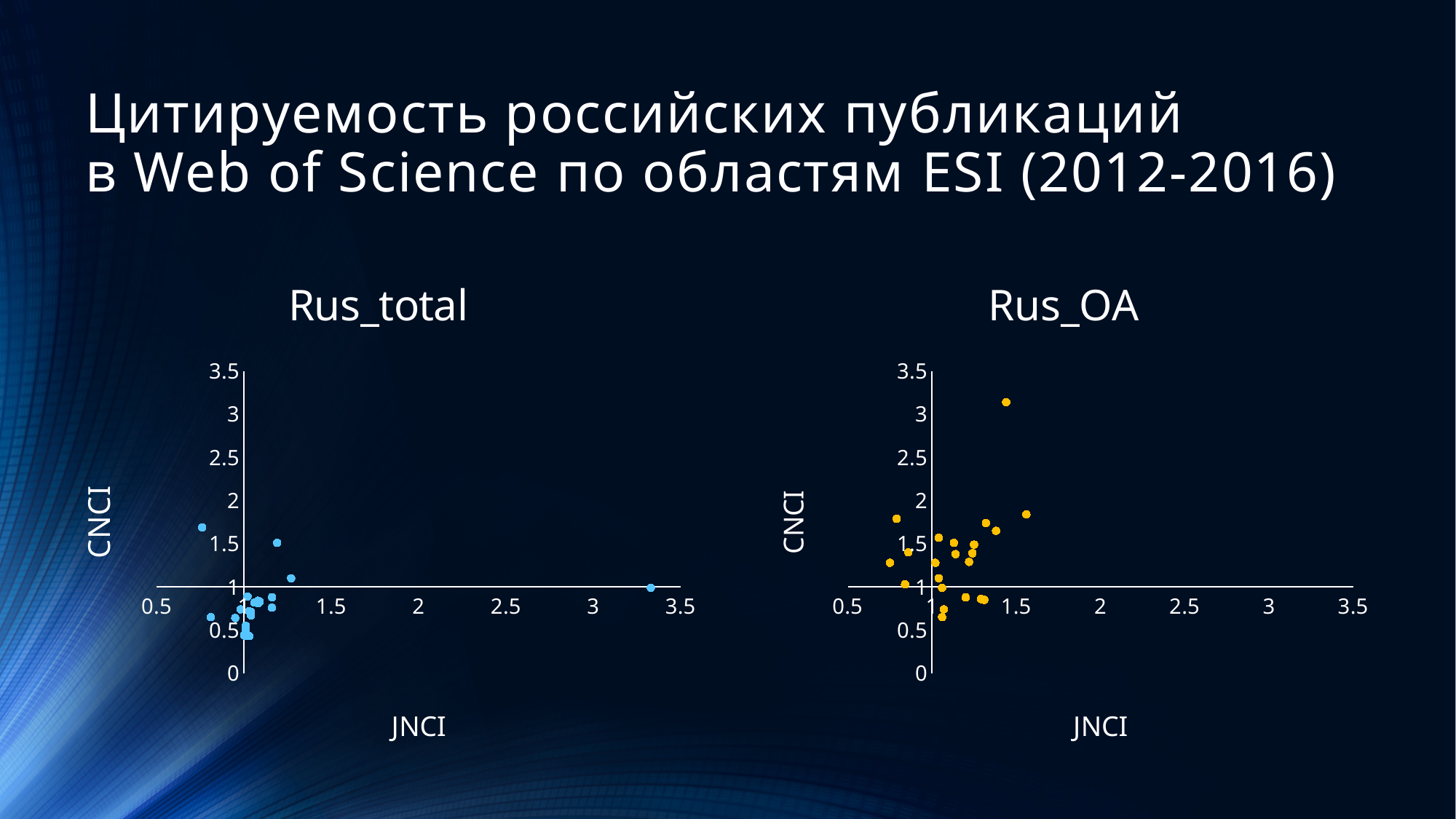
In the Rus_total chart, is the CNCI value of the highest point greater or less than 2? less In the Rus_OA chart, is the CNCI value of the highest point greater or less than 3? greater Which chart, Rus_total or Rus_OA, contains a point with a JNCI value above 3? Rus_total In the Rus_total chart, is the JNCI value of the rightmost point greater or less than 3? greater What kind of chart is the Rus_total chart? scatter chart What is the highest tick value shown on the JNCI axis of the Rus_total chart? 3.5 What label is shown on the vertical axis of the Rus_OA chart? CNCI Which chart, Rus_total or Rus_OA, contains a point with a CNCI value above 3? Rus_OA What is the title of the chart on the right side of the slide? Rus_OA